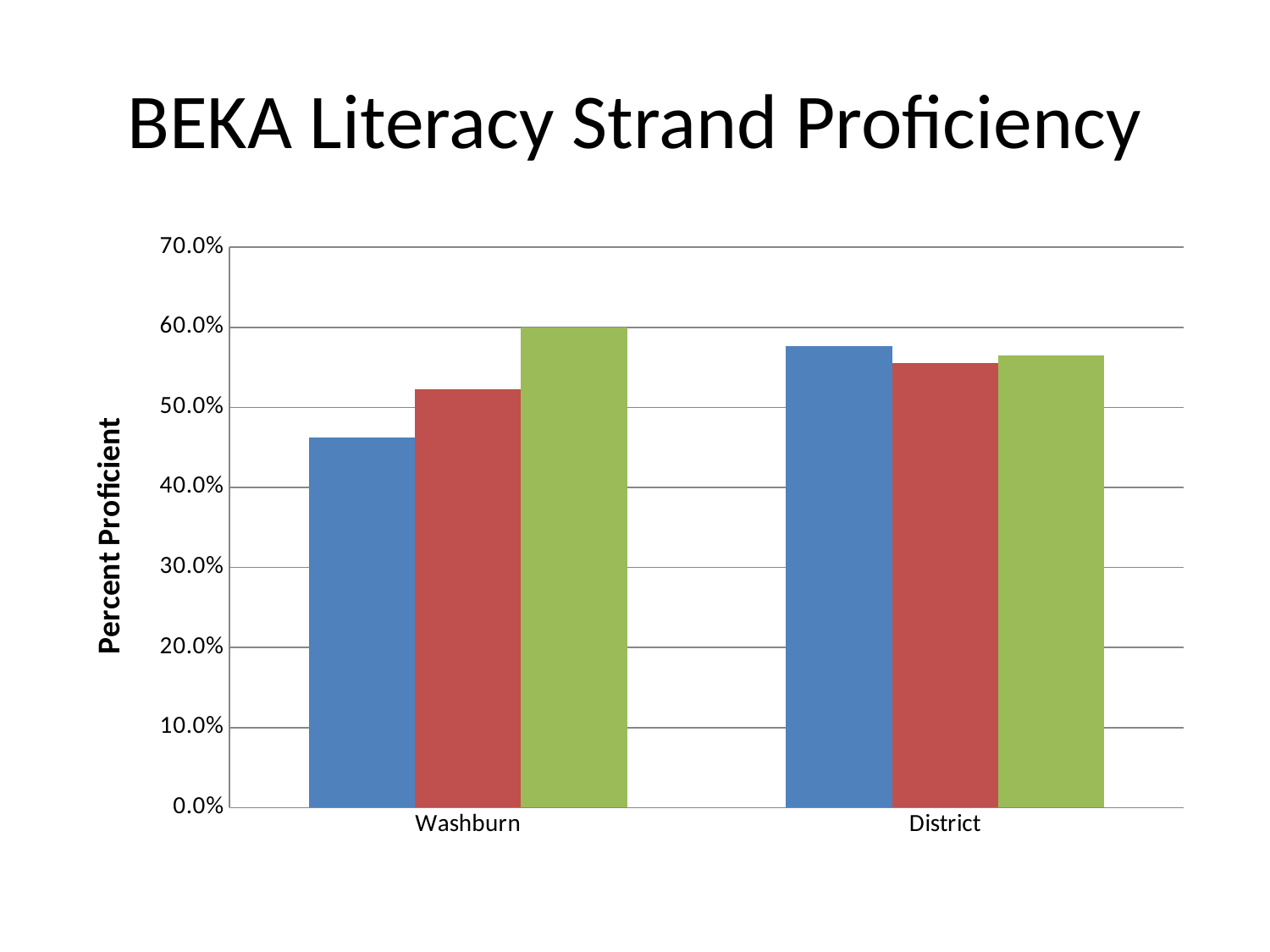
Which is larger, the blue bar for Washburn or the blue bar for District? District Is the value of the blue bar for Washburn greater or less than 50.0%? less Is the value of the red bar for District greater or less than 60.0%? less What kind of chart is shown on the slide? bar chart How many bars are plotted for each category? 3 How many categories are shown on the x axis? 2 Which coloured bar is the lowest for Washburn? blue Is the value of the blue bar for District greater or less than 50.0%? greater What is the label on the vertical axis? Percent Proficient What is the title of the chart? BEKA Literacy Strand Proficiency Which coloured bar is the highest for Washburn? green